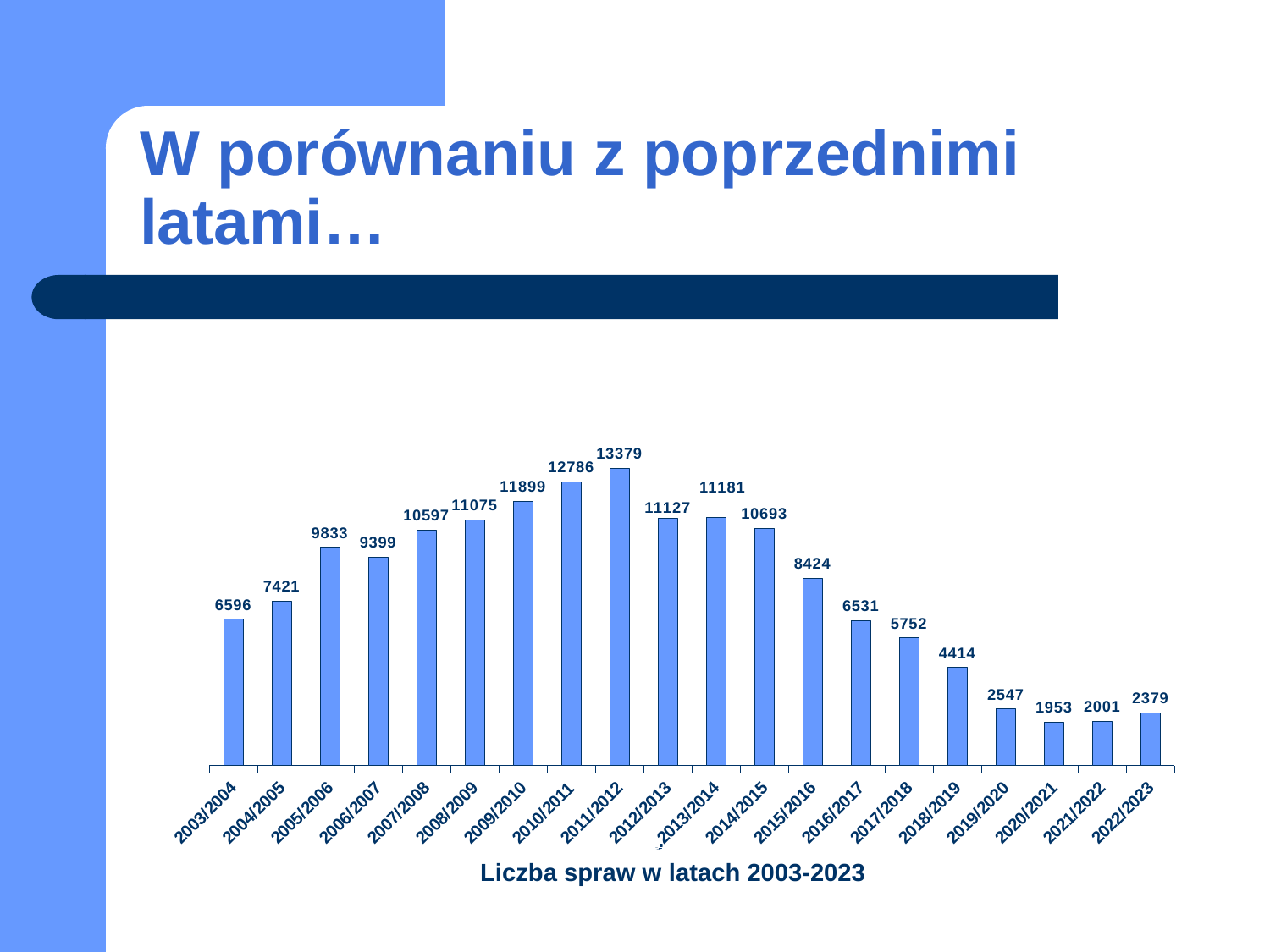
What is the difference between the values for 2016/2017 and 2017/2018? 779 Which is larger, the value for 2012/2013 or the value for 2013/2014? 2013/2014 What is the caption shown below the chart? Liczba spraw w latach 2003-2023 Which is larger, the value for 2005/2006 or the value for 2006/2007? 2005/2006 What is the value for 2018/2019? 4414 Which year has the highest value? 2011/2012 What is the value for 2003/2004? 6596 What is the difference between the values for 2011/2012 and 2010/2011? 593 What kind of chart is shown on the slide? Bar chart How many years are shown on the x axis? 20 Which year has the lowest value? 2020/2021 What is the value for 2011/2012? 13379